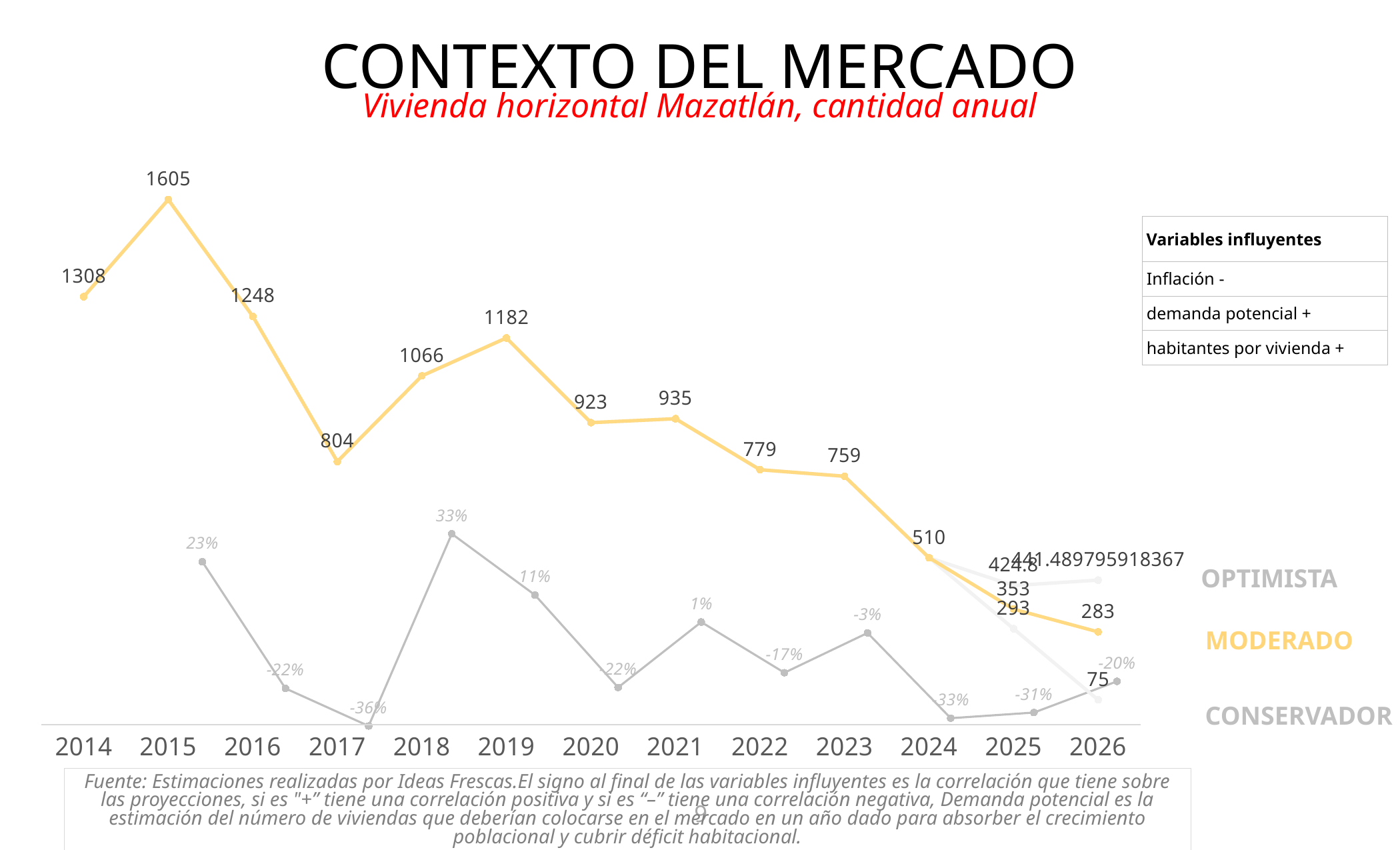
In which year does the moderado (yellow) line reach its highest value? 2015 What type of chart is shown on the slide? Line chart What percentage change is shown on the grey line for 2018? 33% How many years are shown on the x axis? 13 What is the difference between the moderado values for 2015 and 2016? 357 What is the optimista value for 2025? 424.8 In which year does the moderado (yellow) line reach its lowest value? 2026 What is the value of the moderado (yellow) line for 2017? 804 What is the value of the moderado (yellow) line for 2015? 1605 What is the value of the moderado (yellow) line for 2026? 283 What is the conservador value for 2026? 75 Which is larger, the moderado value for 2020 or for 2021? 2021